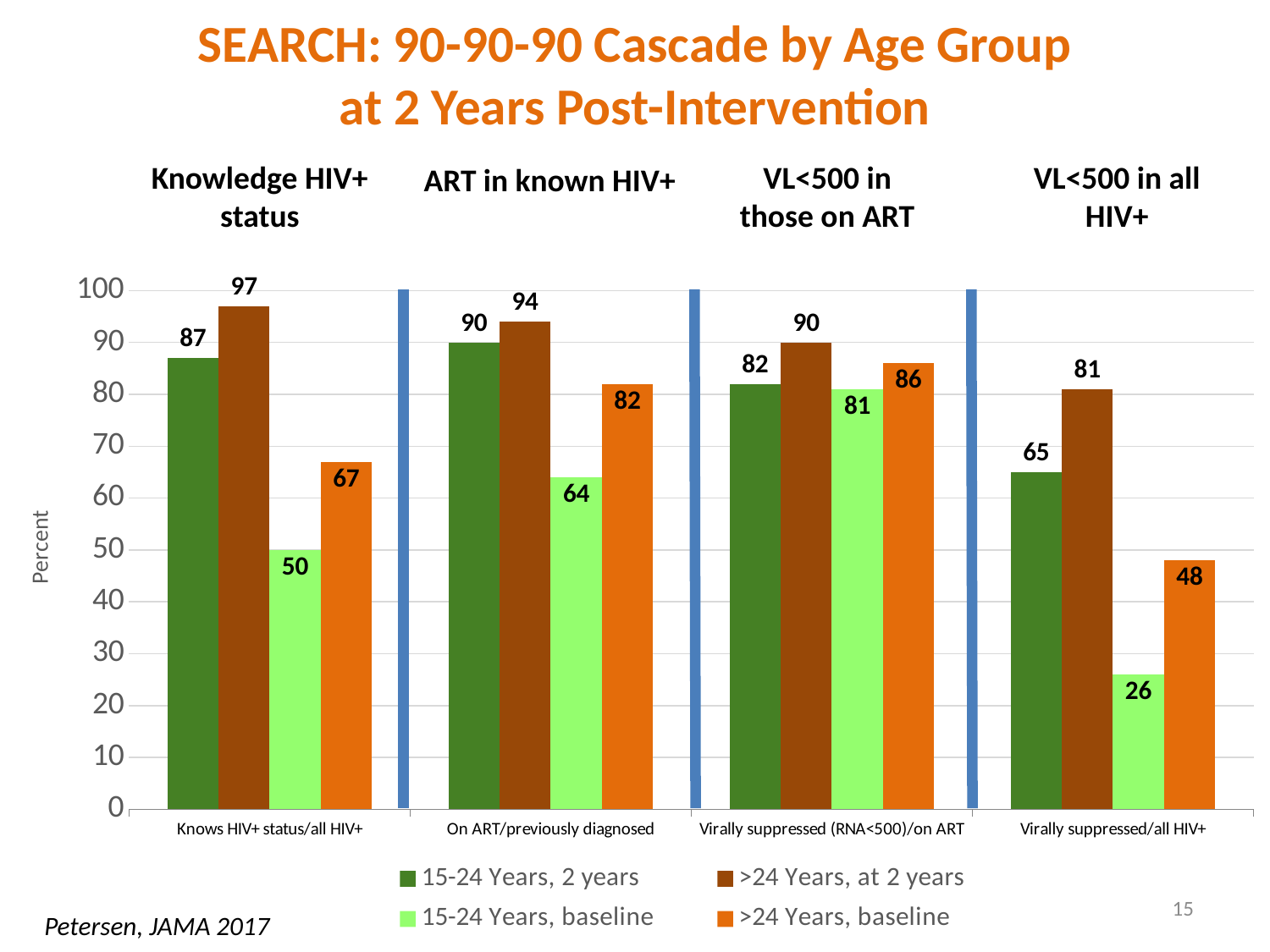
How many series does the legend list? 4 What is the difference between the '>24 Years, at 2 years' and '>24 Years, baseline' values in the 'Knows HIV+ status/all HIV+' category? 30 What is the difference between the '15-24 Years, 2 years' and '15-24 Years, baseline' values in the 'Virally suppressed/all HIV+' category? 39 What kind of chart is shown on the slide? bar chart What is the value for '>24 Years, baseline' in the 'Virally suppressed/all HIV+' category? 48 How many categories are shown on the x axis? 4 What is the value for '15-24 Years, 2 years' in the 'Knows HIV+ status/all HIV+' category? 87 Which series has the lowest value in the 'Virally suppressed/all HIV+' category? 15-24 Years, baseline What is the value for '15-24 Years, baseline' in the 'On ART/previously diagnosed' category? 64 Which series has the highest value in the 'Knows HIV+ status/all HIV+' category? >24 Years, at 2 years What is the label of the y axis? Percent Which is larger in the 'Virally suppressed (RNA<500)/on ART' category: '15-24 Years, 2 years' or '>24 Years, baseline'? >24 Years, baseline